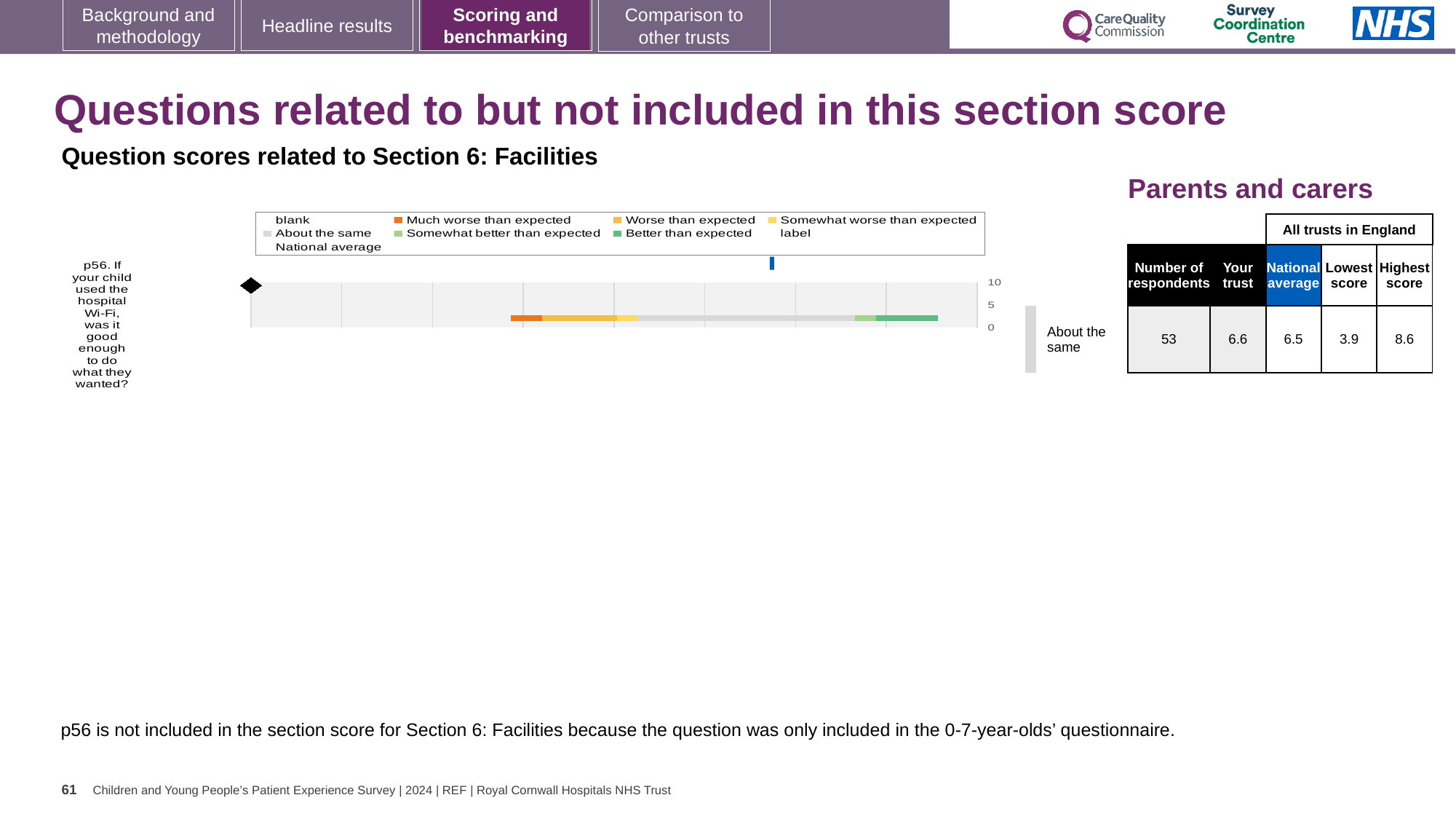
Which question is plotted in the chart? p56. If your child used the hospital Wi-Fi, was it good enough to do what they wanted? What is the National average score for p56? 6.5 What is the Highest score among all trusts in England for p56? 8.6 How many questions are plotted in the chart? 1 What is the score for Your trust for p56? 6.6 What kind of chart is shown on the slide? bar chart What is the difference between the Highest score and the Lowest score for p56? 4.7 What is the difference between the Your trust score and the National average score for p56? 0.1 What is the Lowest score among all trusts in England for p56? 3.9 How many respondents answered p56? 53 Which is larger for p56, the Your trust score or the National average score? Your trust What is the benchmark category shown for p56? About the same